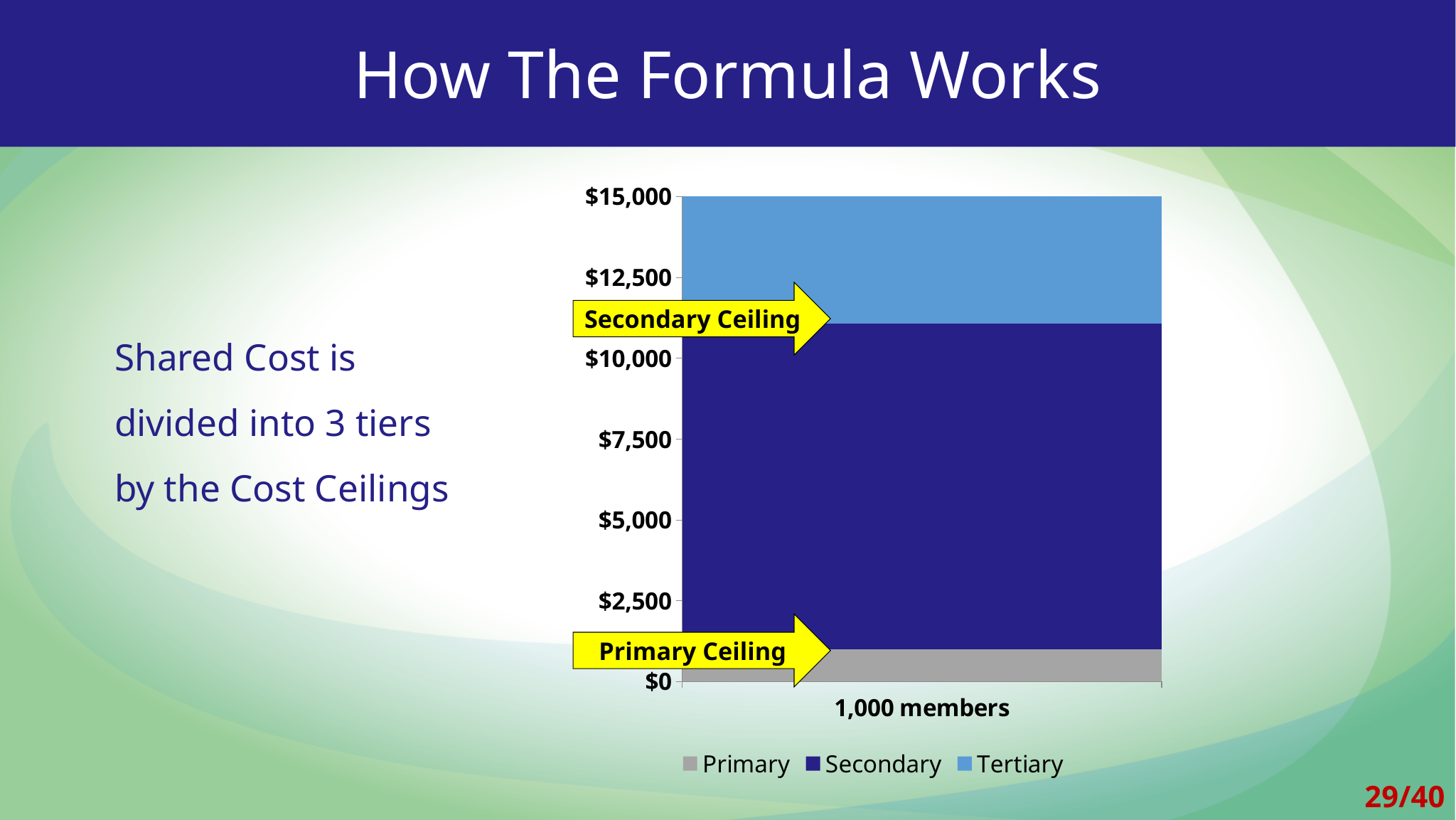
Is the Secondary segment of the bar greater or less than $7,500? greater What are the two ceilings labelled by the yellow arrows on the chart? Primary Ceiling and Secondary Ceiling What kind of chart is shown on the slide? Stacked bar chart What is the total height of the stacked bar for 1,000 members? $15,000 How many categories are shown on the x axis of the chart? 1 How many series does the chart legend list? 3 What is the label of the single category on the x axis? 1,000 members Is the Secondary segment larger or smaller than the Tertiary segment? larger Which series makes up the smallest segment of the stacked bar? Primary Is the Primary segment of the bar greater or less than $2,500? less Which series makes up the largest segment of the stacked bar? Secondary Is the Tertiary segment of the bar greater or less than $5,000? less